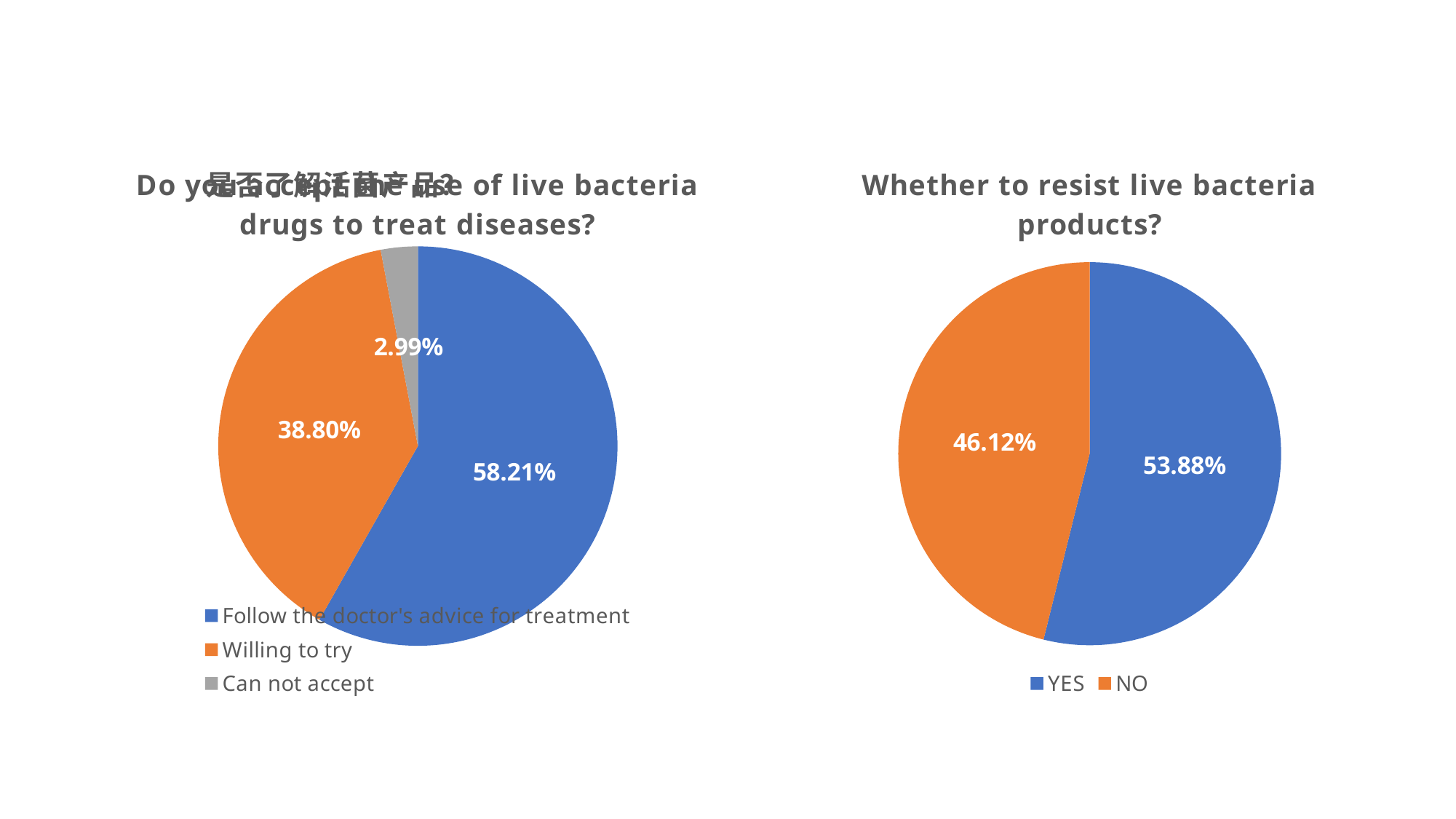
In the chart titled 'Whether to resist live bacteria products?', what is the difference between the YES and NO shares? 7.76% In the chart titled 'Whether to resist live bacteria products?', what percentage answered NO? 46.12% In the chart titled 'Whether to resist live bacteria products?', what percentage answered YES? 53.88% In the left pie chart, which category has the smallest slice? Can not accept What type of chart is the chart titled 'Whether to resist live bacteria products?'? Pie chart In the left pie chart, what percentage is shown for 'Can not accept'? 2.99% In the left pie chart, what percentage is shown for 'Willing to try'? 38.80% How many categories does the left pie chart's legend list? 3 In the chart titled 'Whether to resist live bacteria products?', which is larger, YES or NO? YES In the left pie chart, what is the difference between the 'Follow the doctor's advice for treatment' and 'Willing to try' shares? 19.41% In the left pie chart, what share is labelled for 'Follow the doctor's advice for treatment'? 58.21% In the left pie chart, which category has the largest slice? Follow the doctor's advice for treatment